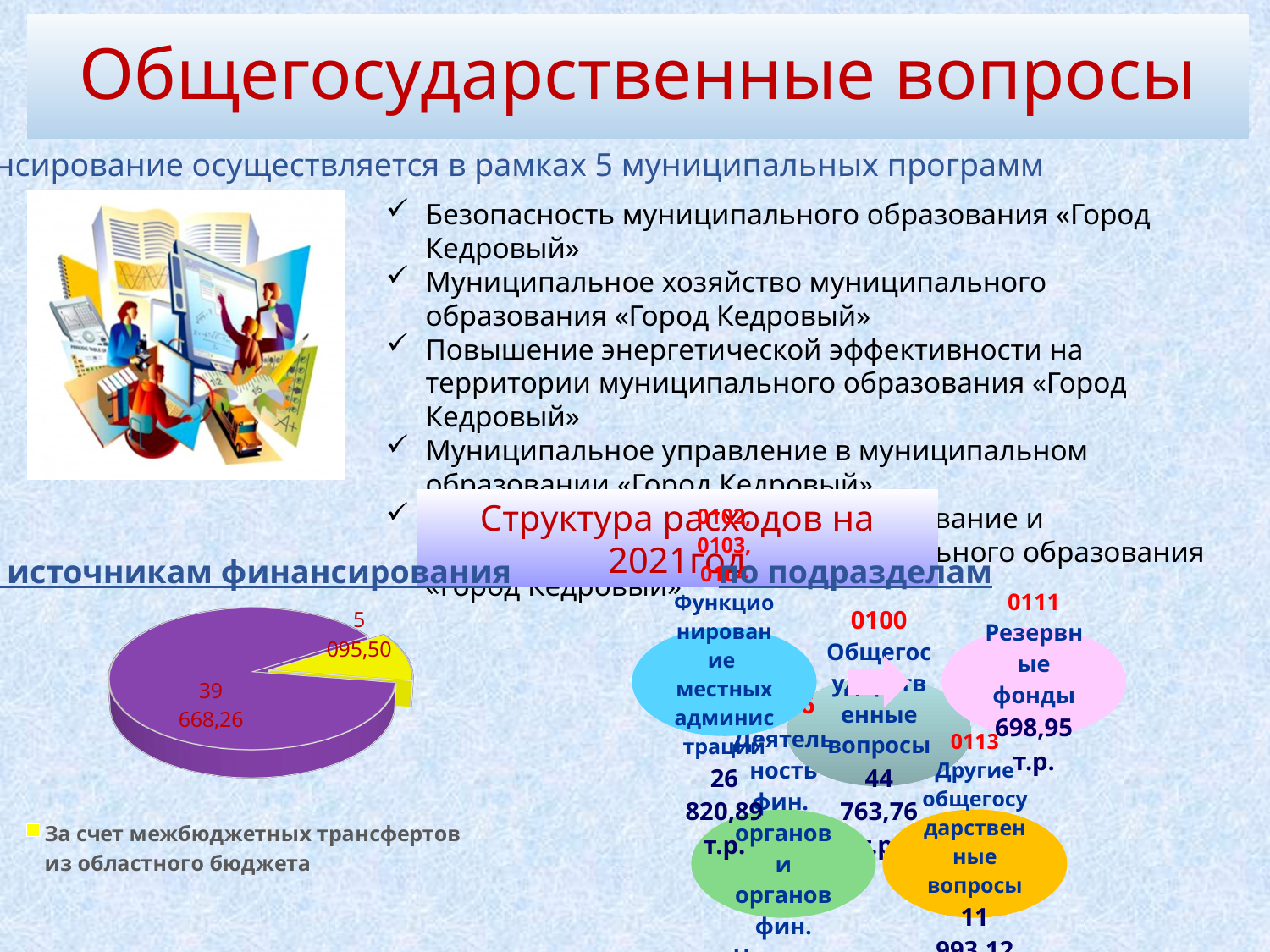
In the pie chart on the left, what is the total of the two slices? 44 763,76 In the diagram on the right under "по подразделам", what value is shown for "0100 Общегосударственные вопросы"? 44 763,76 т.р. In the pie chart on the left, what is the value of the large purple slice? 39 668,26 What kind of chart is shown on the left under "по источникам финансирования"? pie chart How many slices does the pie chart on the left have? 2 In the pie chart on the left, what is the value of the smallest slice? 5 095,50 In the pie chart on the left, what is the difference between the two slice values, 39 668,26 and 5 095,50? 34 572,76 In the pie chart on the left, what is the value of the slice "За счет межбюджетных трансфертов из областного бюджета"? 5 095,50 In the pie chart on the left, what is the value of the largest slice? 39 668,26 In the diagram on the right under "по подразделам", what value is shown for "0111 Резервные фонды"? 698,95 т.р. In the pie chart on the left, what colour is the exploded (pulled-out) slice? yellow In the pie chart on the left, which slice is larger: the purple one or the yellow one? the purple one